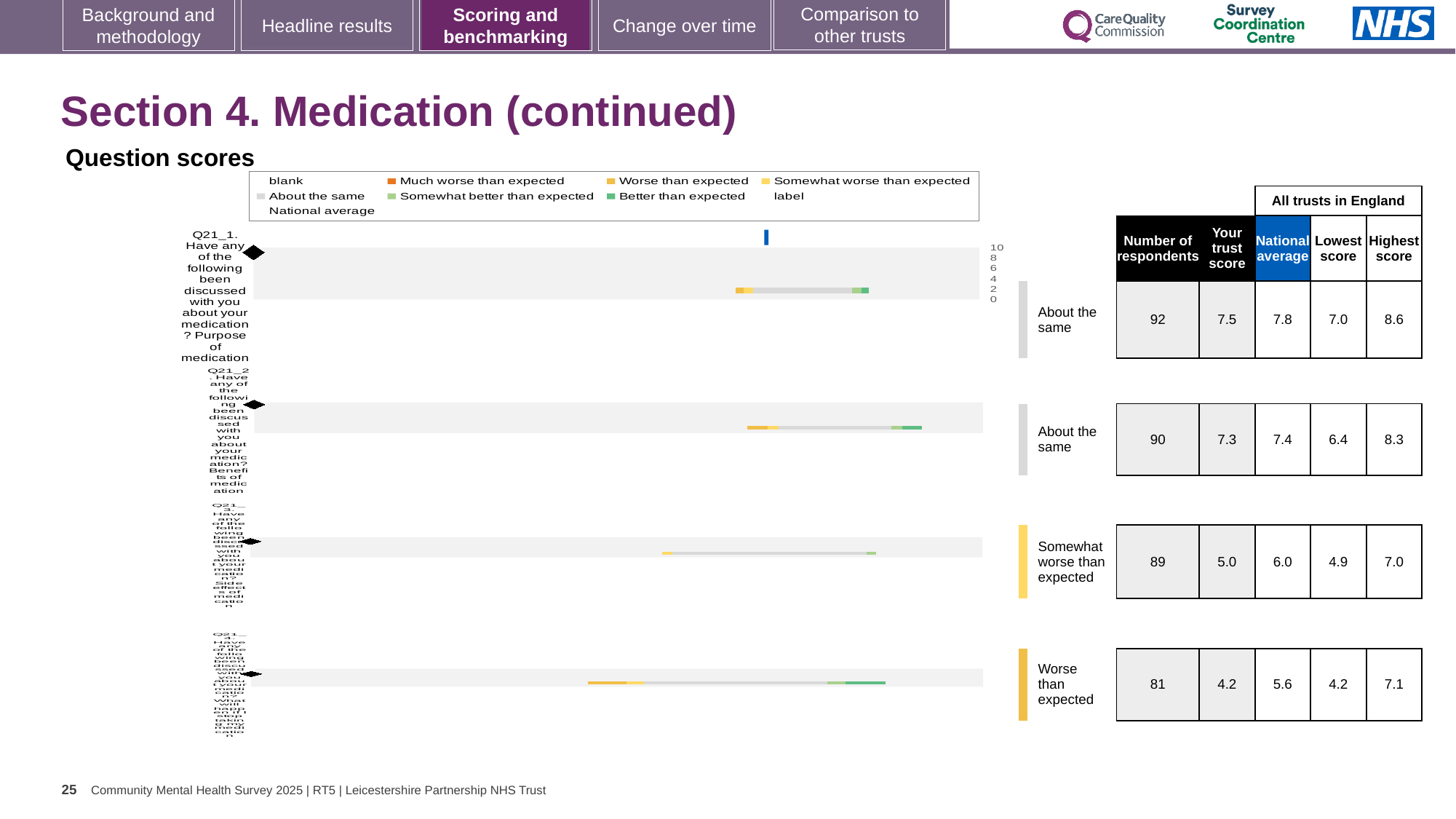
Which question row has the lowest 'Your trust score'? Q21_4 What is the highest score among all trusts in England for Q21_2 (Benefits of medication)? 8.3 What is the 'Your trust score' for the fourth row, Q21_4? 4.2 Which question row has the highest 'Your trust score'? Q21_1 (Purpose of medication) What benchmark category label is shown for the fourth row, Q21_4? Worse than expected How many question rows (bars) are plotted in the chart? 4 For Q21_3 (third row), which is larger: the trust score or the national average? National average What is the national average for Q21_1 (Purpose of medication)? 7.8 What kind of chart is shown under 'Question scores'? bar chart What is the difference between the national average and the trust score for Q21_1 (Purpose of medication)? 0.3 How many respondents answered Q21_2 (Benefits of medication)? 90 What is the 'Your trust score' for Q21_1 (Purpose of medication)? 7.5